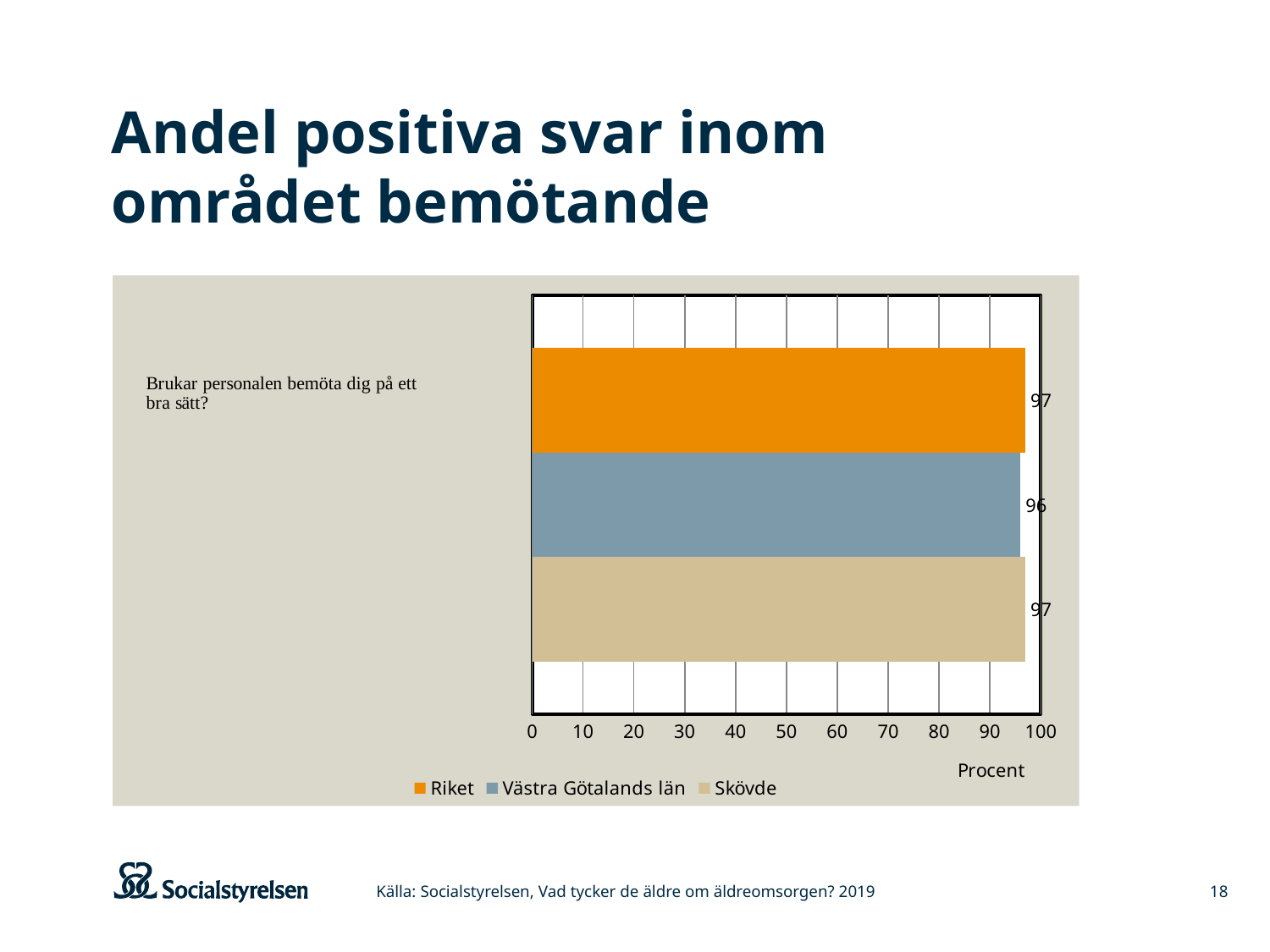
What is the value for Västra Götalands län? 96 What is the value for Skövde? 97 What is the difference between the values for Riket and Västra Götalands län? 1 How many series does the legend list? 3 Which is larger, the value for Skövde or the value for Västra Götalands län? Skövde Which series has the lowest value? Västra Götalands län Is the value for Västra Götalands län greater or less than 90? greater Which series is shown in orange? Riket What is the value for Riket? 97 What is the highest value shown on the x axis? 100 What kind of chart is shown on the slide? bar chart What is the label on the x axis? Procent